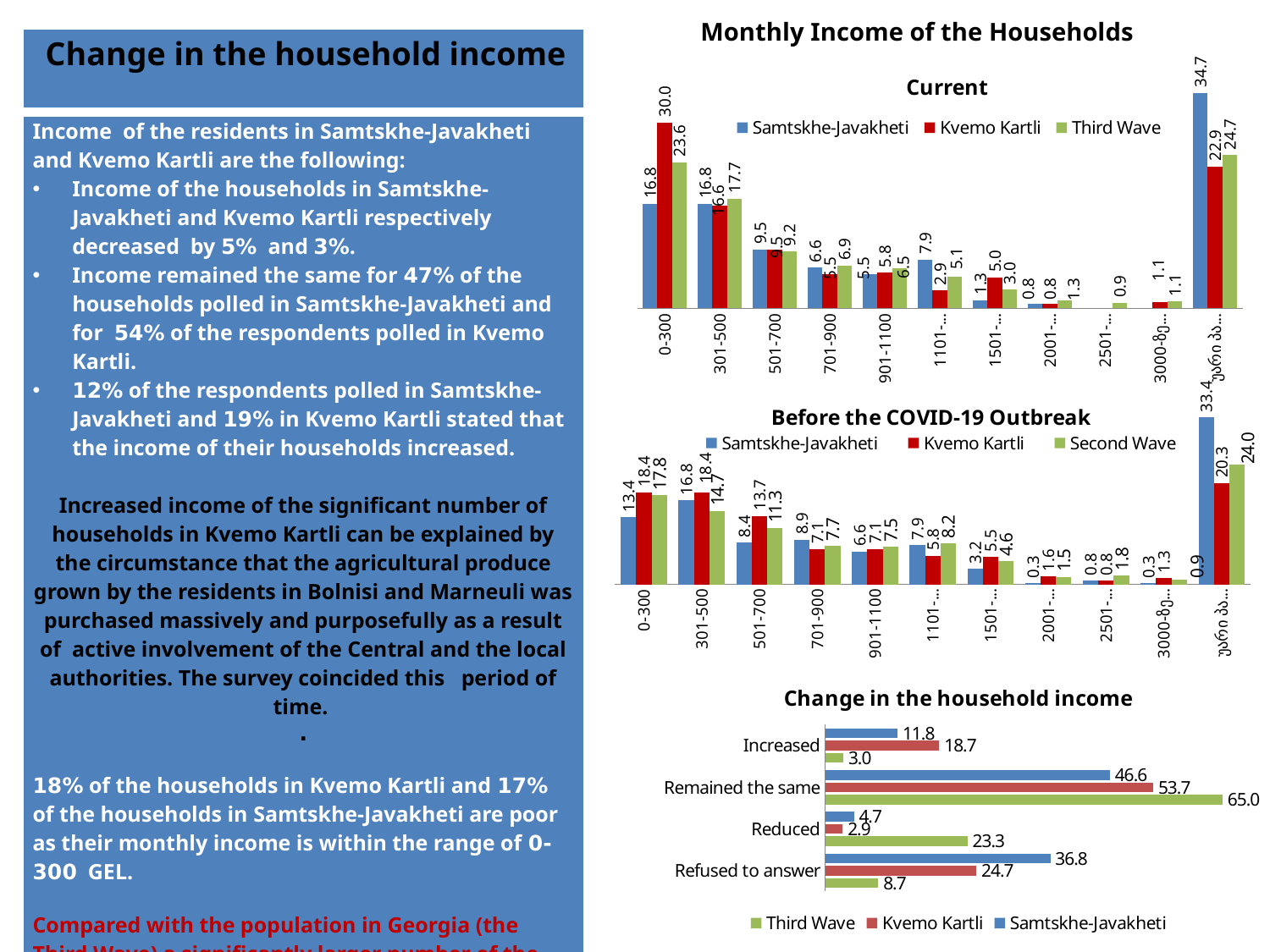
In the 'Before the COVID-19 Outbreak' chart, what is the value for Kvemo Kartli in the 501-700 category? 13.7 In the 'Before the COVID-19 Outbreak' chart, what is the name of the third series in the legend? Second Wave In the 'Current' monthly income chart, what is the value for Third Wave in the 301-500 category? 17.7 In the 'Change in the household income' chart, which category has the highest value for Samtskhe-Javakheti? Remained the same In the 'Current' monthly income chart, what is the value for Kvemo Kartli in the 0-300 category? 30.0 In the 'Change in the household income' chart, what is the value for Third Wave in the 'Reduced' category? 23.3 In the 'Current' monthly income chart, which series has the highest value in the 0-300 category? Kvemo Kartli In the 'Before the COVID-19 Outbreak' chart, which is larger in the 701-900 category: Samtskhe-Javakheti or Kvemo Kartli? Samtskhe-Javakheti In the 'Change in the household income' chart, how many series does the legend list? 3 What kind of chart is the 'Change in the household income' chart? Bar chart In the 'Change in the household income' chart, what is the difference between the Third Wave and Samtskhe-Javakheti values for 'Remained the same'? 18.4 In the 'Change in the household income' chart, what is the value for Kvemo Kartli in the 'Remained the same' category? 53.7